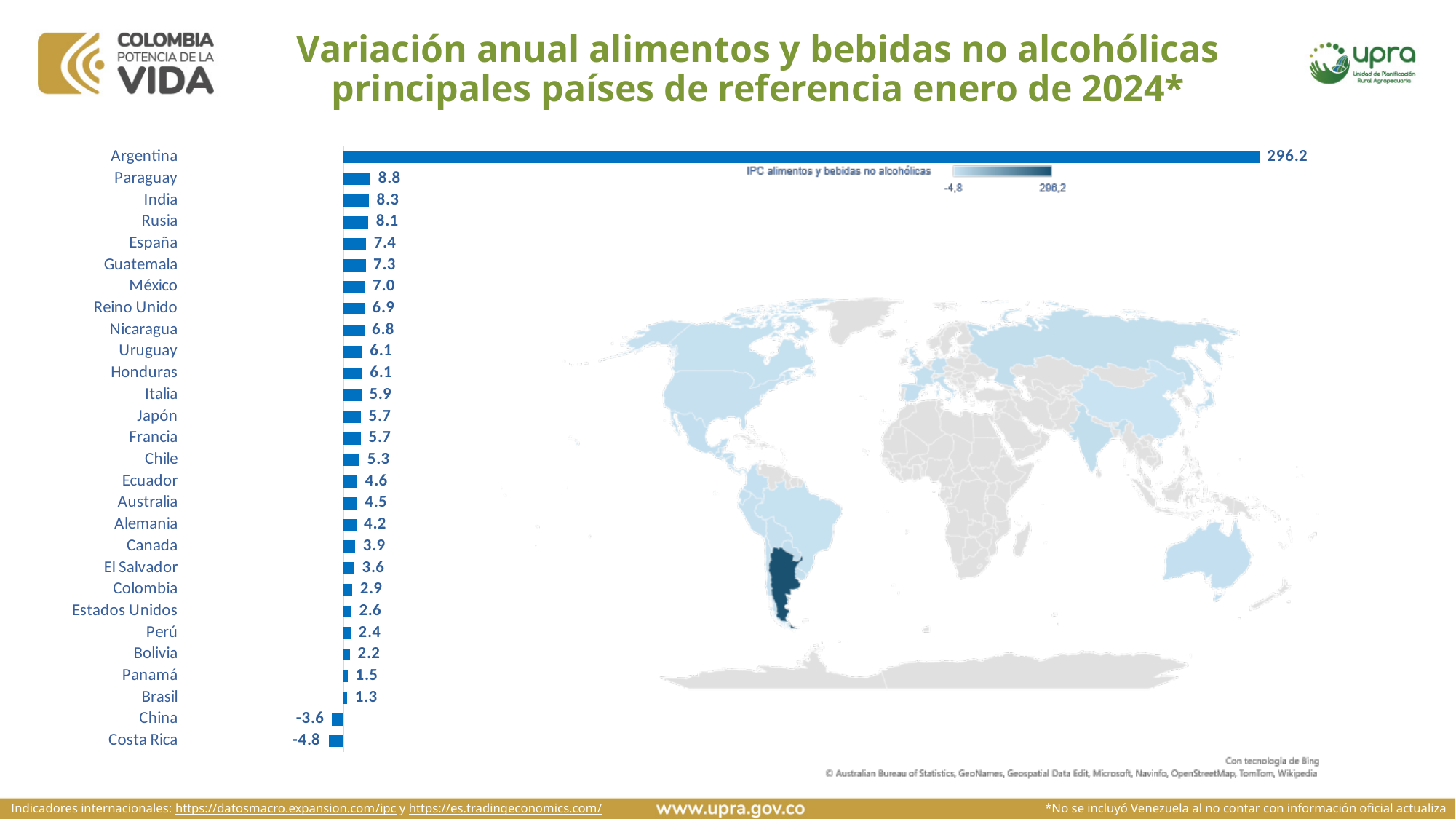
In the bar chart, how many countries have a negative value? 2 How many countries are shown in the bar chart? 28 What kind of chart is the chart on the left of the slide? Bar chart In the bar chart, which country has the lowest value? Costa Rica In the bar chart, what is the difference between the values for Paraguay and India? 0.5 In the bar chart, what is the difference between the values for Colombia and Estados Unidos? 0.3 In the bar chart, what is the value for Colombia? 2.9 In the bar chart, which has a larger value, México or Chile? México In the bar chart, what is the value for Costa Rica? -4.8 In the bar chart, what is the value for Japón? 5.7 In the bar chart, what is the value for Argentina? 296.2 In the bar chart, which country has the highest value? Argentina